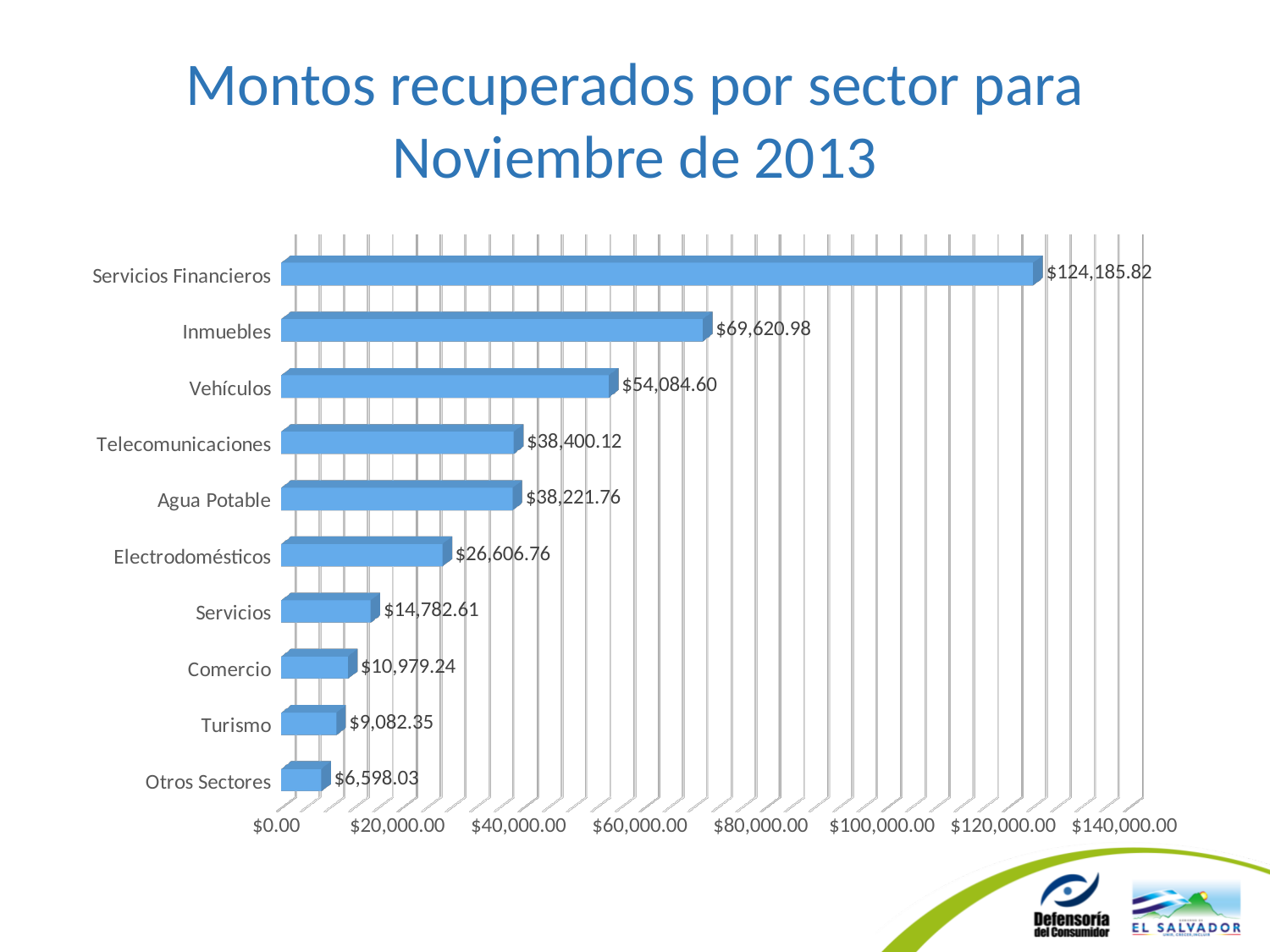
What kind of chart is shown on the slide? Bar chart What is the title of the chart on the slide? Montos recuperados por sector para Noviembre de 2013 What is the difference between the recovered amounts for Comercio and Otros Sectores? $4,381.21 Which sector has the highest recovered amount? Servicios Financieros What is the difference between the recovered amounts for Inmuebles and Vehículos? $15,536.38 How many sectors are shown in the chart? 10 What is the recovered amount for Turismo? $9,082.35 Which has a larger recovered amount, Electrodomésticos or Servicios? Electrodomésticos What is the recovered amount for Servicios Financieros? $124,185.82 Which sector has the lowest recovered amount? Otros Sectores What is the recovered amount for Telecomunicaciones? $38,400.12 Is the value for Inmuebles greater or less than $60,000.00? greater